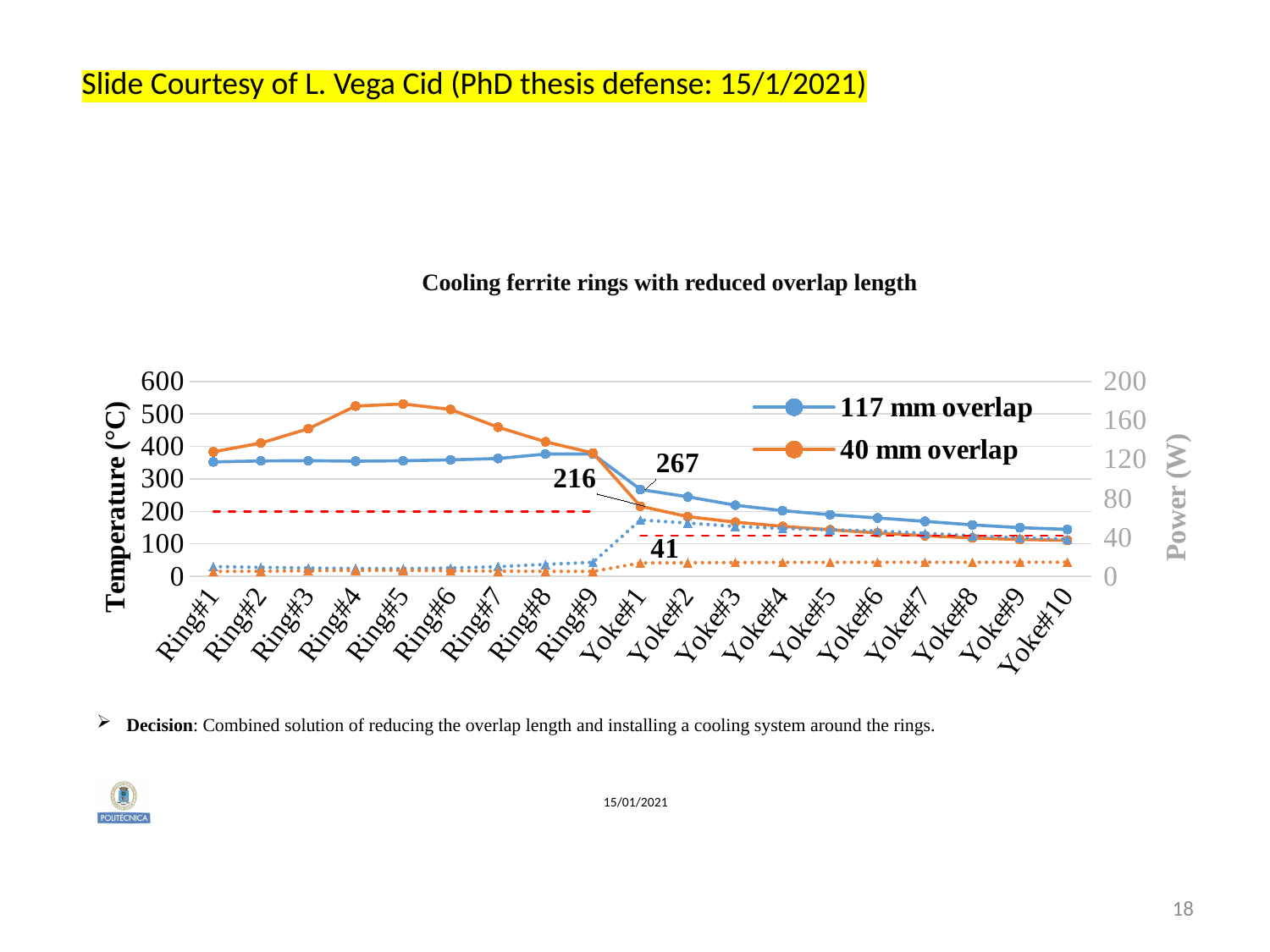
What is the labelled value of the 117 mm overlap series at Yoke#1? 267 How many series does the legend of the chart list? 2 Is the temperature of the 40 mm overlap series at Ring#5 greater or less than 500? greater How many categories are shown along the x axis of the chart? 19 Does the 117 mm overlap temperature rise or fall from Yoke#1 to Yoke#10? fall At Yoke#1, which series has the higher temperature, 117 mm overlap or 40 mm overlap? 117 mm overlap What is the title of the left vertical axis of the chart? Temperature (°C) At Ring#5, which series has the higher temperature, 117 mm overlap or 40 mm overlap? 40 mm overlap Is the temperature of the 117 mm overlap series at Ring#1 greater or less than 400? less What kind of chart is shown on the slide? line chart What is the difference between the 117 mm overlap and 40 mm overlap values at Yoke#1? 51 What is the labelled value of the 40 mm overlap series at Yoke#1? 216